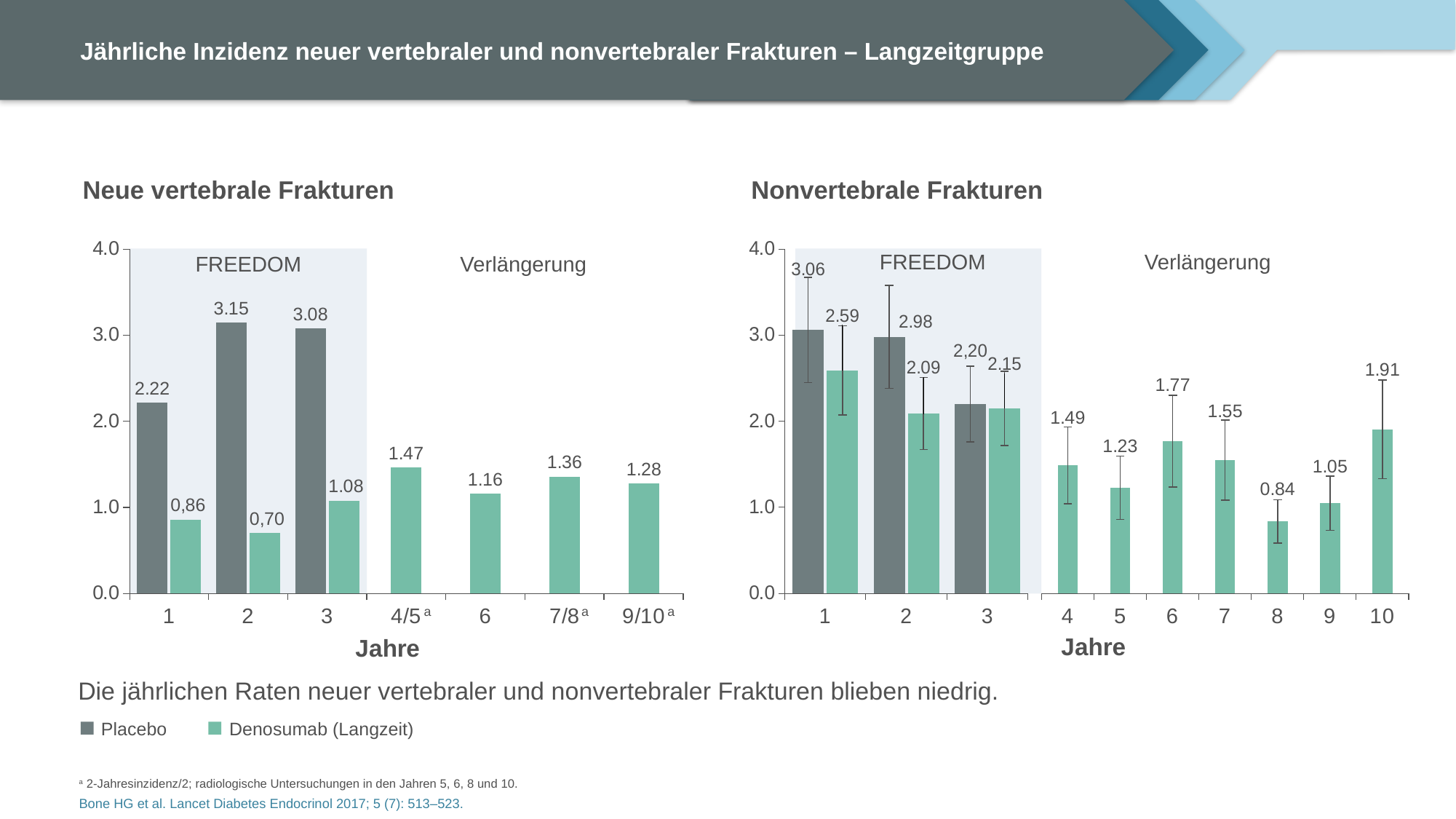
In the 'Nonvertebrale Frakturen' chart, how many years are shown on the x axis? 10 In the 'Nonvertebrale Frakturen' chart, what is the Denosumab (Langzeit) value for year 8? 0.84 What type of chart is the 'Neue vertebrale Frakturen' chart? Bar chart In the 'Nonvertebrale Frakturen' chart, what is the Placebo value for year 1? 3.06 In the 'Neue vertebrale Frakturen' chart, what is the Denosumab (Langzeit) value for year 2? 0,70 In the 'Nonvertebrale Frakturen' chart, which year has the lowest Denosumab (Langzeit) value? 8 In the 'Neue vertebrale Frakturen' chart, which year has the highest Placebo value? 2 In the 'Neue vertebrale Frakturen' chart, what is the Placebo value for year 2? 3.15 In the 'Nonvertebrale Frakturen' chart, is the Denosumab (Langzeit) value for year 6 or year 10 larger? Year 10 How many series does the legend list? 2 In the 'Neue vertebrale Frakturen' chart, what is the difference between the Placebo and Denosumab (Langzeit) values for year 3? 2.00 In the 'Neue vertebrale Frakturen' chart, what is the Denosumab (Langzeit) value for years 9/10? 1.28